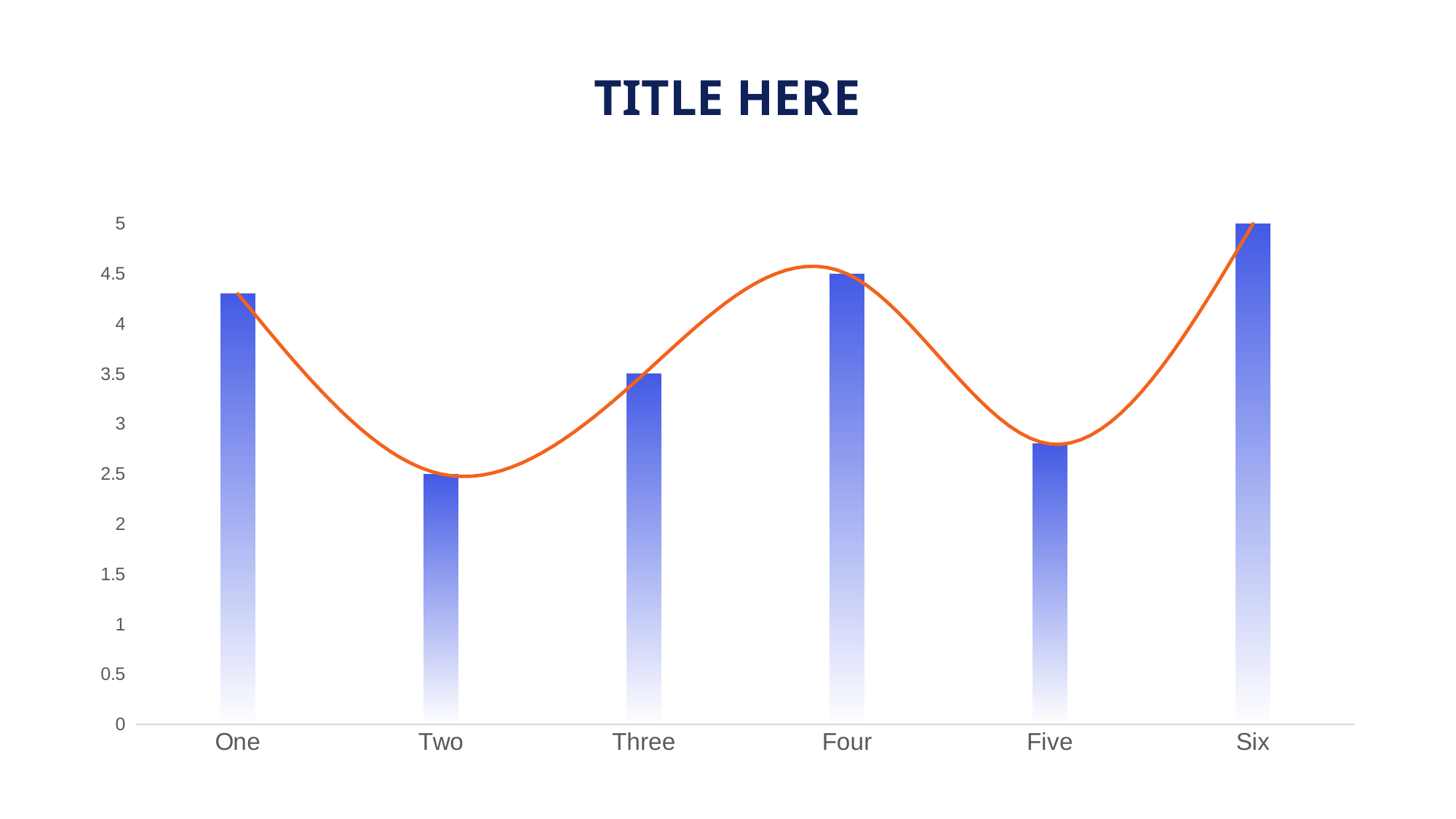
Which category has the highest bar? Six What is the value of the bar for Six? 5 Which category has the lowest bar? Two What is the title of the chart? TITLE HERE What kind of chart is shown on the slide? bar chart with a line How many categories are shown on the x axis? 6 What is the difference between the bars for Six and Two? 2.5 Is the value for Five greater or less than 3? less Is the value for One greater or less than 4? greater What is the value of the bar for Four? 4.5 What is the value of the bar for Three? 3.5 What is the value of the bar for Two? 2.5